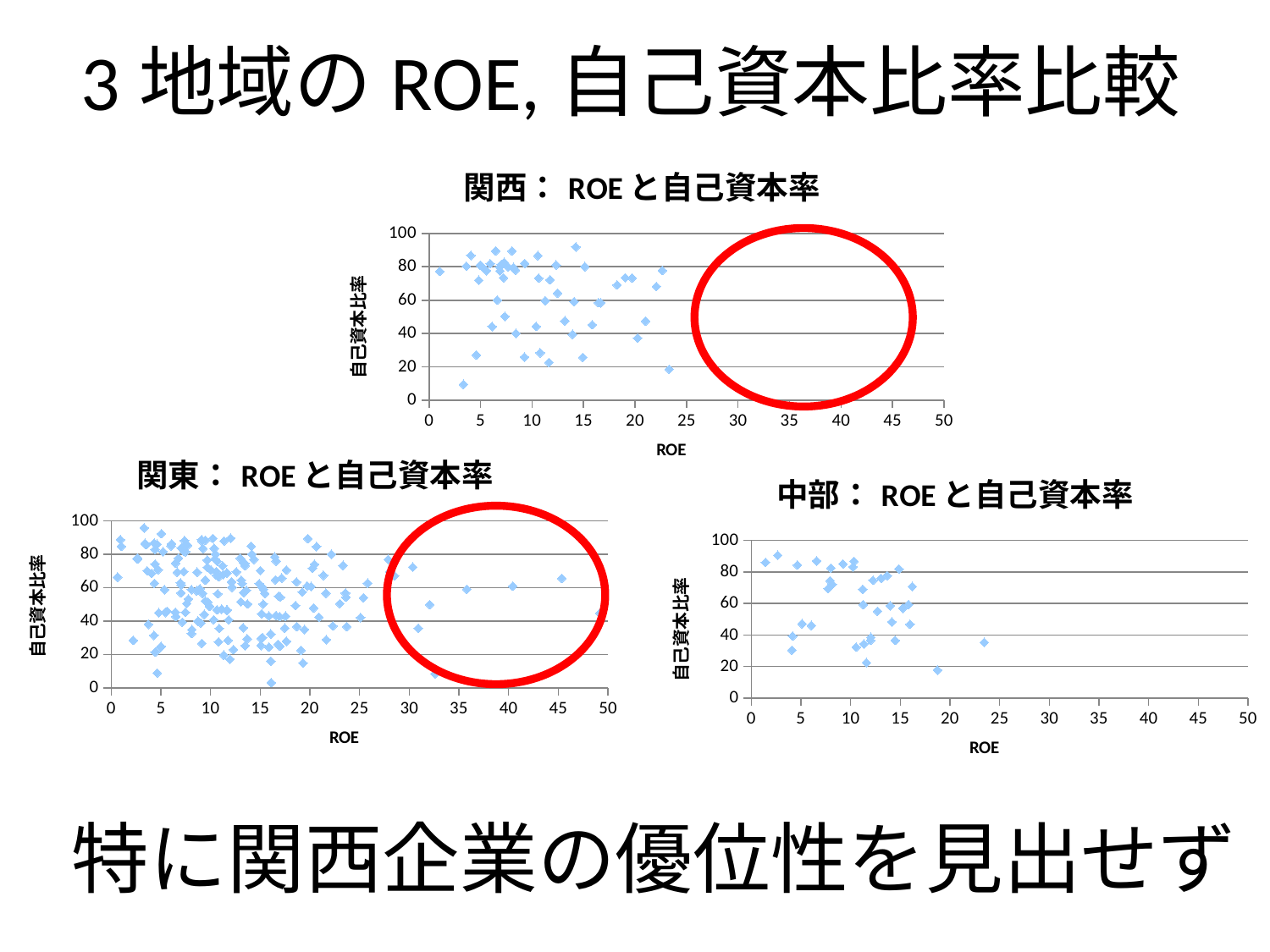
What is the label of the y axis on the 中部： ROEと自己資本率 chart? 自己資本比率 Which region's chart has the most data points plotted? 関東 Which region's chart has the fewest data points plotted? 中部 On the 関西： ROEと自己資本率 chart, are there any data points with ROE greater than 25? No On the 関東： ROEと自己資本率 chart, is the highest ROE value plotted greater or less than 45? greater Which of the three charts contains data points with ROE greater than 30? 関東： ROEと自己資本率 How many charts are shown on the slide? 3 What is the label of the x axis on the 関東： ROEと自己資本率 chart? ROE On the 中部： ROEと自己資本率 chart, are there any data points with ROE greater than 25? No What kind of chart is the 関西： ROEと自己資本率 chart? scatter chart